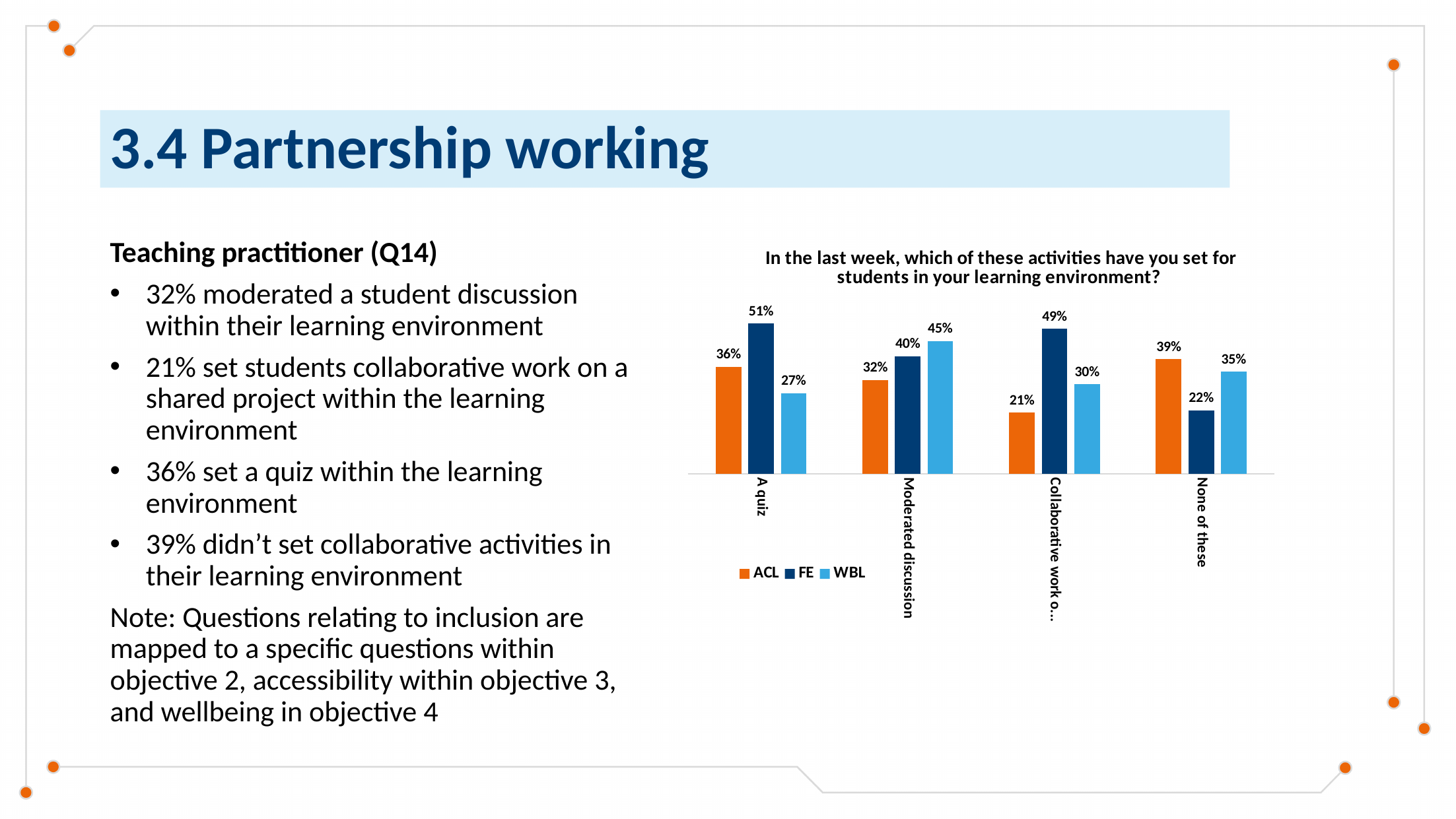
Which is larger for 'Moderated discussion': the ACL value or the WBL value? WBL How many series does the legend list? 3 What is the value for WBL for 'Moderated discussion'? 45% What is the difference between the ACL and FE values for 'None of these'? 17% What is the value for ACL for 'None of these'? 39% Which category has the lowest ACL value? Collaborative work o... What kind of chart is shown on the slide? Bar chart How many categories are shown on the x axis? 4 Which category has the highest FE value? A quiz Which series is shown in orange in the legend? ACL What is the value for FE for 'A quiz'? 51% What is the difference between the FE and WBL values for 'A quiz'? 24%